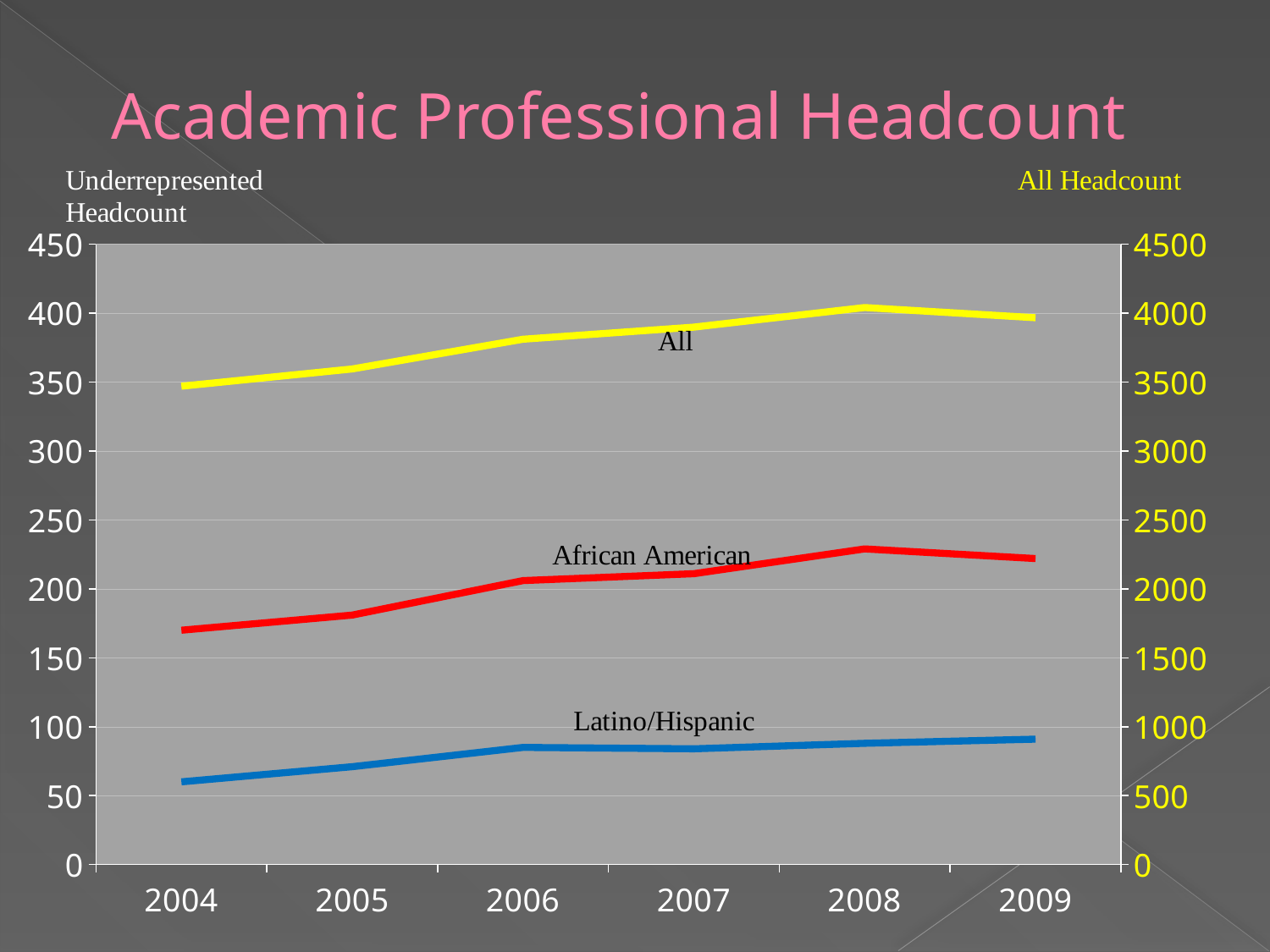
How many years are plotted along the x axis? 6 What kind of chart is shown on the slide? line chart In which year is the Latino/Hispanic line at its lowest? 2004 What is the label of the right-hand axis? All Headcount Is the All headcount value for 2006 greater or less than 3500? greater In which year does the African American line reach its highest value? 2008 Does the Latino/Hispanic line generally rise or fall from 2004 to 2009? rise Is the African American value for 2008 greater or less than 200? greater How many lines (series) are plotted on the chart? 3 Which series is plotted in yellow? All Is the Latino/Hispanic value for 2009 greater or less than 100? less